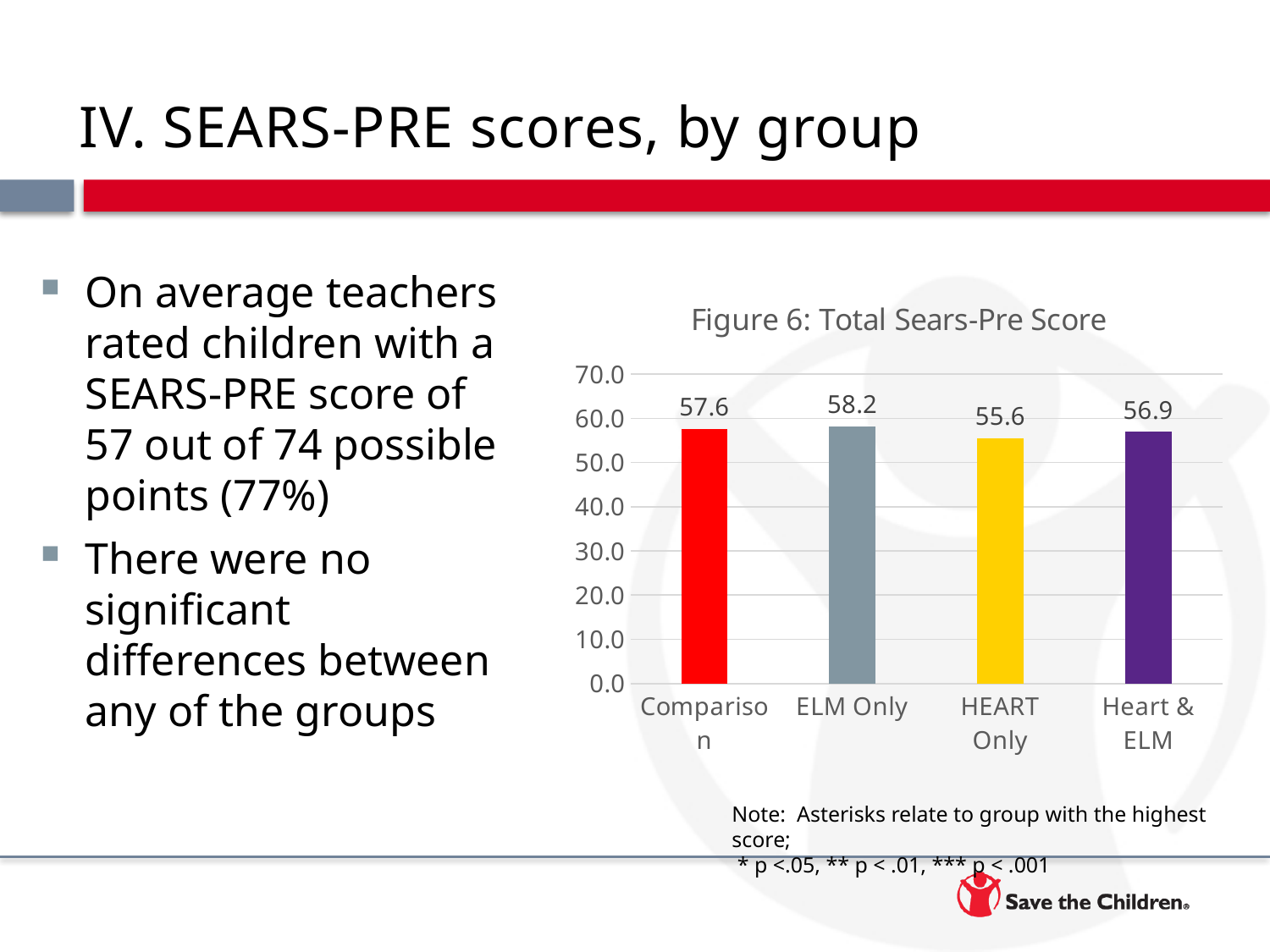
How many groups are shown in the chart? 4 Which group has a higher score, Comparison or Heart & ELM? Comparison What is the difference between the ELM Only score and the HEART Only score? 2.6 What is the Total Sears-Pre Score for the HEART Only group? 55.6 Is the value for HEART Only greater or less than 60.0? less Which group has the highest Total Sears-Pre Score? ELM Only What is the Total Sears-Pre Score for the Comparison group? 57.6 What is the Total Sears-Pre Score for the ELM Only group? 58.2 What kind of chart is shown on the slide? Bar chart Which group has the lowest Total Sears-Pre Score? HEART Only What is the title of the chart? Figure 6: Total Sears-Pre Score What is the Total Sears-Pre Score for the Heart & ELM group? 56.9